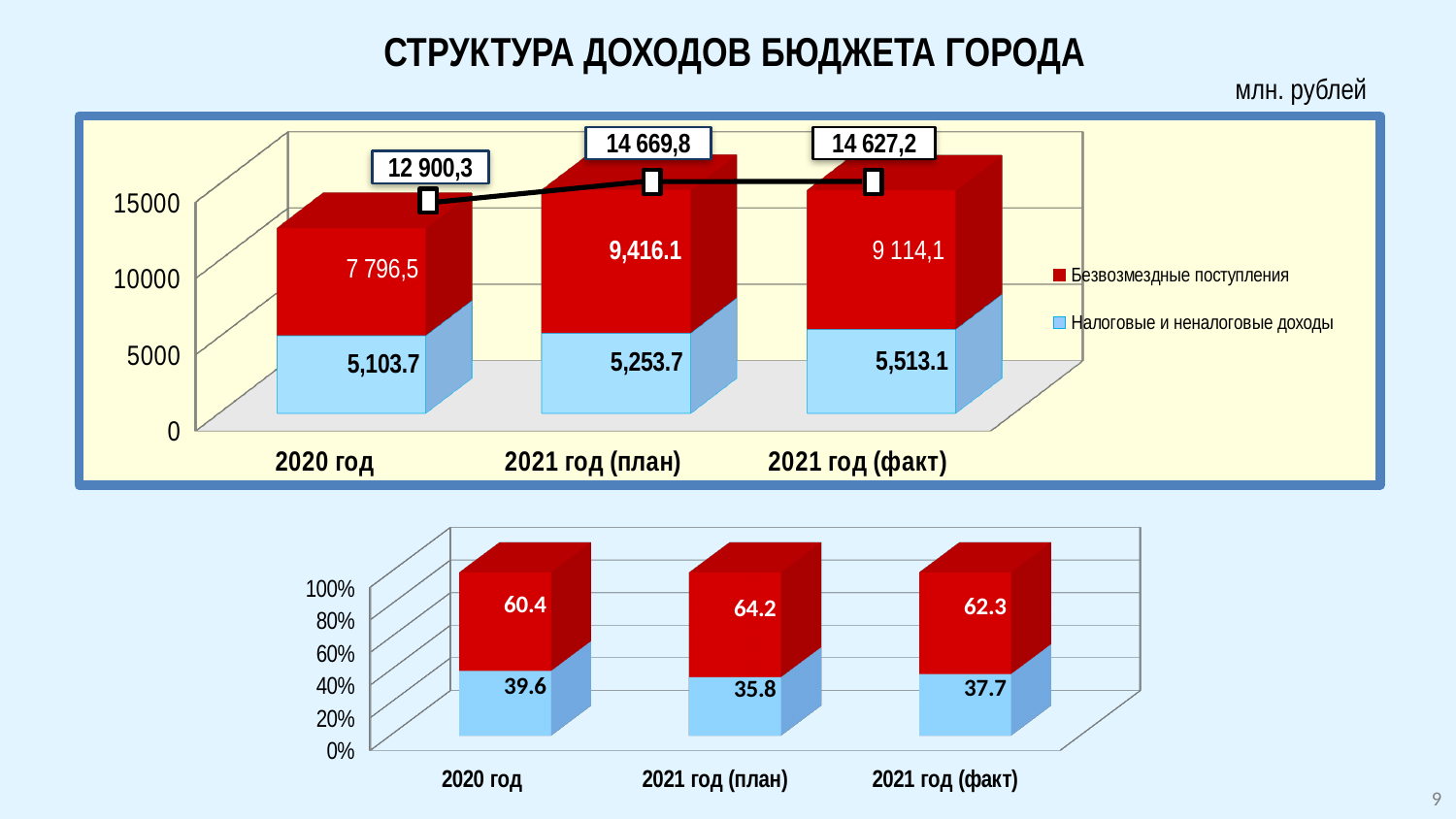
In the top chart, what total is shown above the bar for 2021 год (план)? 14 669,8 How many categories are shown on the x axis of the bottom chart? 3 How many series does the legend of the top chart list? 2 In the top chart, what is the value of Налоговые и неналоговые доходы for 2021 год (факт)? 5,513.1 What kind of chart is the bottom chart? Stacked bar chart In the top chart, which category has the lowest value for Налоговые и неналоговые доходы? 2020 год In the bottom chart, which category has the lowest value for the blue segment? 2021 год (план) In the top chart, what is the value of Безвозмездные поступления for 2020 год? 7 796,5 In the bottom chart, what is the value of the blue segment for 2020 год? 39.6 In the top chart, is the value of Безвозмездные поступления larger for 2021 год (план) or 2021 год (факт)? 2021 год (план) In the bottom chart, what is the share of the red segment for 2021 год (план)? 64.2 In the top chart, which category has the highest total shown on the line? 2021 год (план)